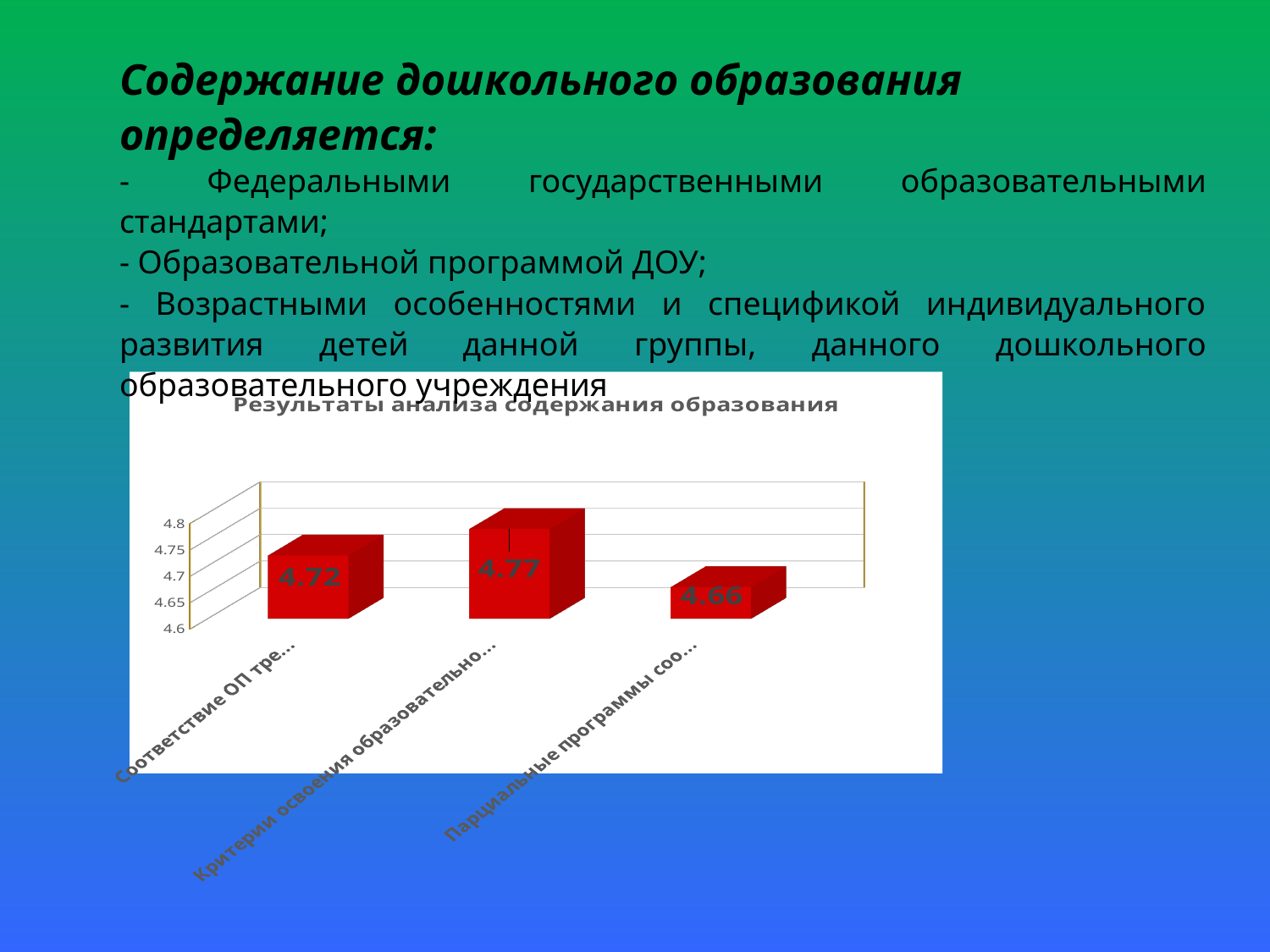
What is the value of the third bar (Парциальные программы соо...)? 4.66 What is the difference between the first bar (4.72) and the third bar (4.66)? 0.06 What is the title of the chart on the slide? Результаты анализа содержания образования What kind of chart is shown on the slide? bar chart Which is larger, the value of the first bar or the value of the second bar? the second bar How many bars does the chart show? 3 Which bar has the highest value? the second bar (Критерии освоения образовательно...) What is the difference between the highest and lowest values in the chart? 0.11 What is the value of the first bar (Соответствие ОП тре...)? 4.72 What is the value of the second bar (Критерии освоения образовательно...)? 4.77 Which bar has the lowest value? the third bar (Парциальные программы соо...) What colour are the bars in the chart? red